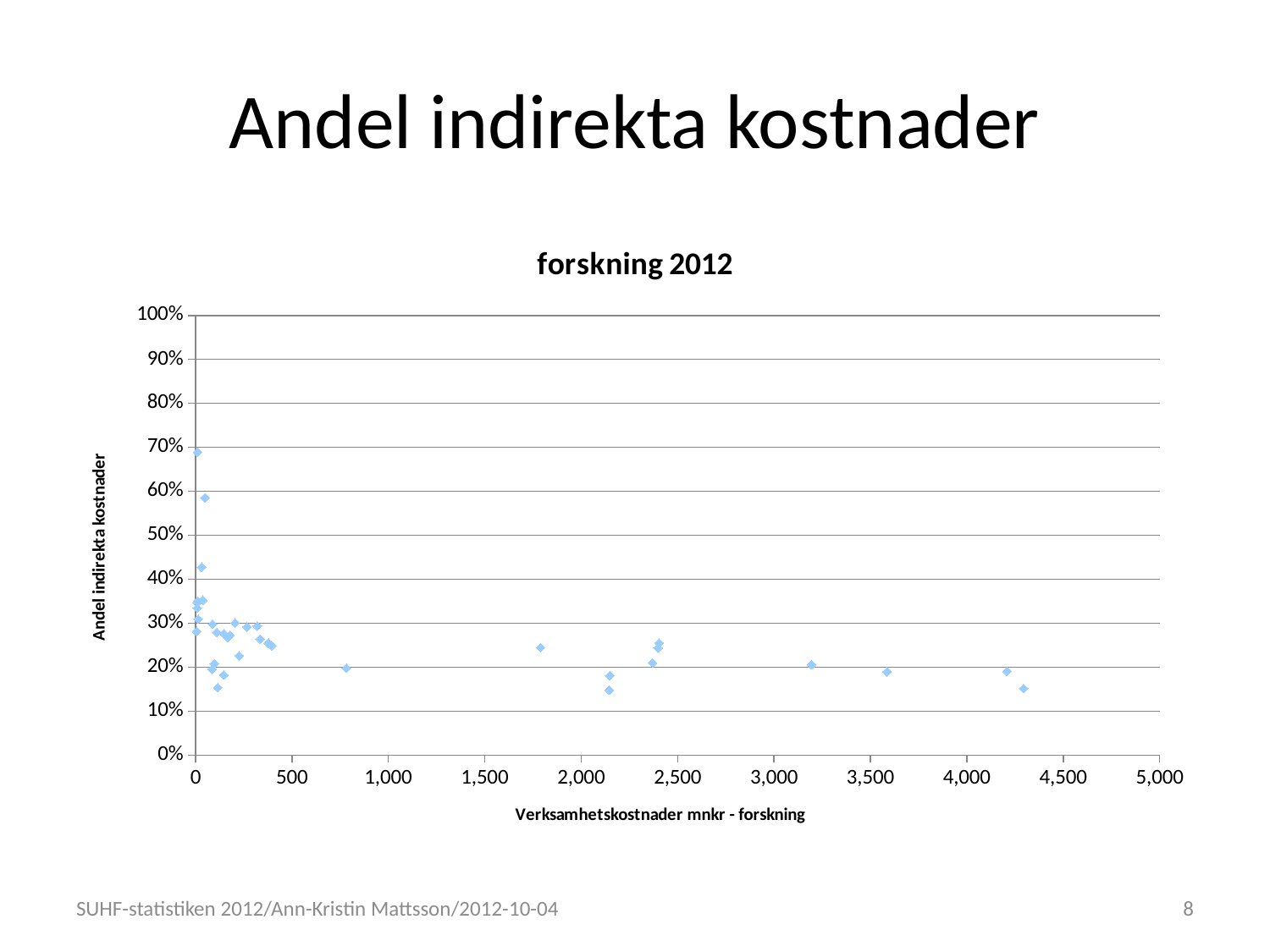
What is the title of the x axis of the chart? Verksamhetskostnader mnkr - forskning Is the value of the point at about 3,600 on the x axis greater or less than 10%? greater Is the value of the point at about 4,300 on the x axis greater or less than 20%? less Is the value of the point at about 800 on the x axis greater or less than 30%? less What is the title of the chart? forskning 2012 Are the highest values on the chart found at low or high values on the x axis? low What kind of chart is shown on the slide? scatter chart Is the point at about 4,300 on the x axis higher or lower than the point at about 4,200? lower Do the points with the largest x values have higher or lower shares than the cluster of points near 0 on the x axis? lower